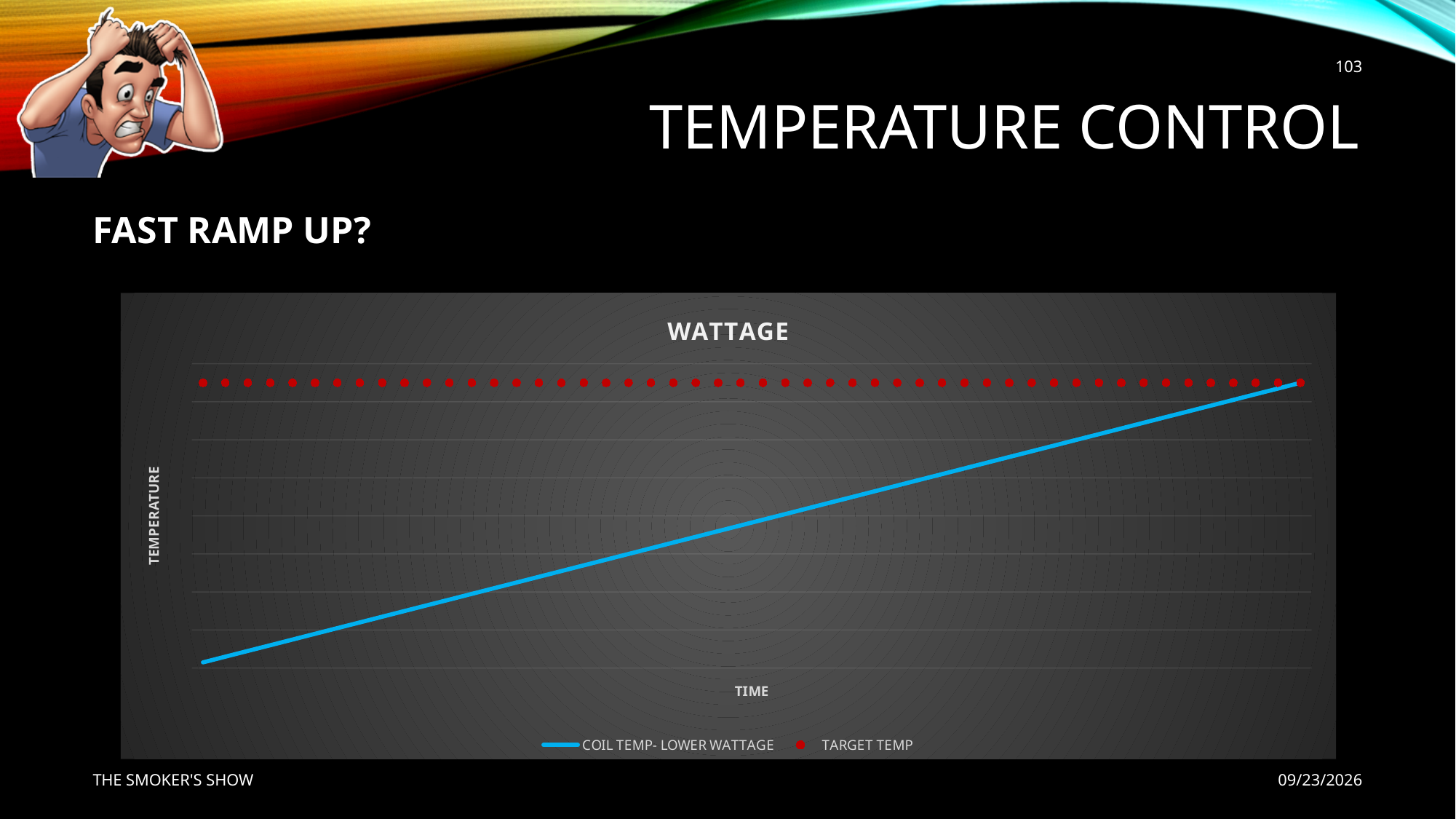
Does the TARGET TEMP series rise, fall, or stay flat along the x axis? stay flat What kind of chart is shown on the slide? line chart At the start of the time axis, which is higher: TARGET TEMP or COIL TEMP- LOWER WATTAGE? TARGET TEMP What label is shown on the vertical axis of the chart? TEMPERATURE What is the title of the chart? WATTAGE How many series does the legend of the chart list? 2 Does the COIL TEMP- LOWER WATTAGE line rise or fall as time increases along the x axis? rise